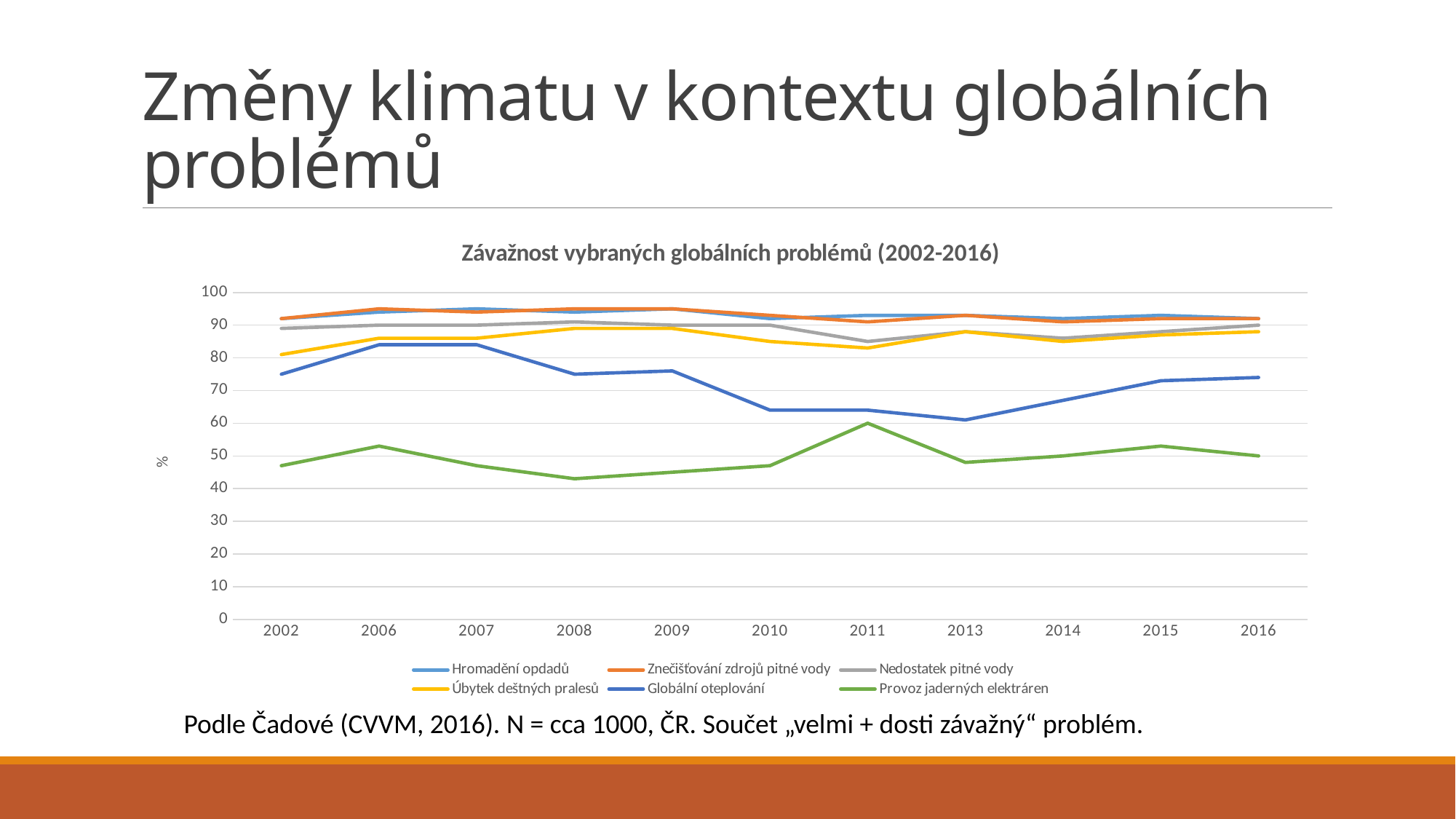
Does the value for Globální oteplování rise or fall from 2009 to 2013? fall Is the value for Úbytek deštných pralesů in 2002 greater or less than 90? less What is the title of the chart? Závažnost vybraných globálních problémů (2002-2016) Is the value for Globální oteplování in 2006 greater or less than 80? greater How many series does the legend list? 6 Is the value for Provoz jaderných elektráren in 2008 greater or less than 50? less How many years are shown on the x axis? 11 What kind of chart is shown on the slide? line chart Does the value for Provoz jaderných elektráren rise or fall from 2008 to 2011? rise In 2002, which is larger: Globální oteplování or Provoz jaderných elektráren? Globální oteplování Which series has the lowest values across the whole chart? Provoz jaderných elektráren